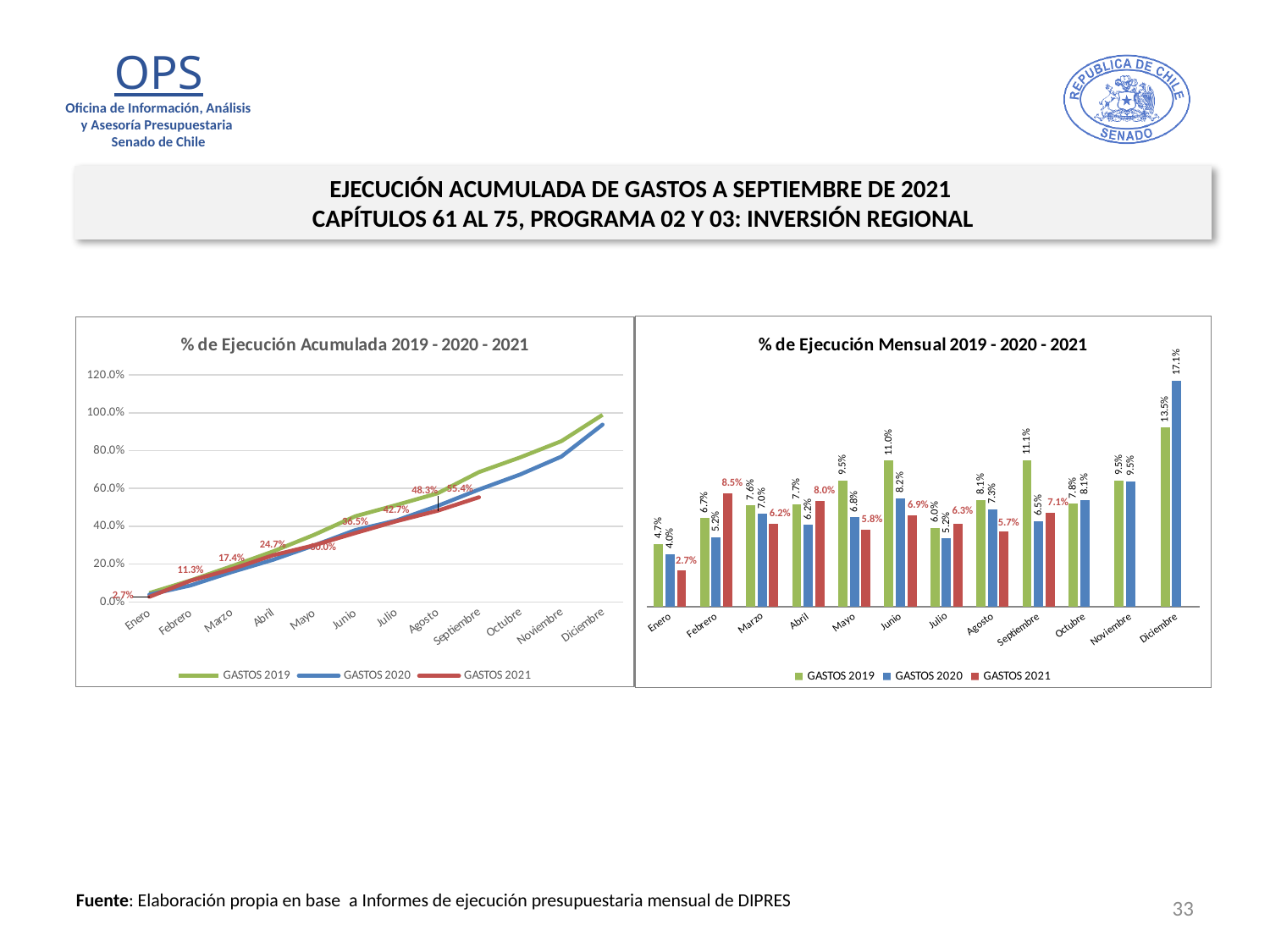
In the chart titled '% de Ejecución Mensual 2019 - 2020 - 2021', what is the difference between GASTOS 2019 and GASTOS 2020 in Junio? 2.8% In the chart titled '% de Ejecución Acumulada 2019 - 2020 - 2021', what is the labelled value for GASTOS 2021 in Septiembre? 55.4% How many series does the legend list in the chart titled '% de Ejecución Acumulada 2019 - 2020 - 2021'? 3 In the chart titled '% de Ejecución Mensual 2019 - 2020 - 2021', which month has the lowest value for GASTOS 2021? Enero In the chart titled '% de Ejecución Acumulada 2019 - 2020 - 2021', do the GASTOS 2021 values rise or fall from Enero to Septiembre? Rise In the chart titled '% de Ejecución Acumulada 2019 - 2020 - 2021', is the value for GASTOS 2019 in Diciembre greater or less than 80.0%? greater What kind of chart is the one titled '% de Ejecución Mensual 2019 - 2020 - 2021'? Bar chart In the chart titled '% de Ejecución Mensual 2019 - 2020 - 2021', which is larger in Abril: GASTOS 2019 or GASTOS 2021? GASTOS 2021 In the chart titled '% de Ejecución Mensual 2019 - 2020 - 2021', which month has the highest value for GASTOS 2019? Diciembre How many months are shown on the x axis of the chart titled '% de Ejecución Mensual 2019 - 2020 - 2021'? 12 In the chart titled '% de Ejecución Mensual 2019 - 2020 - 2021', what is the value for GASTOS 2020 in Diciembre? 17.1% In the chart titled '% de Ejecución Mensual 2019 - 2020 - 2021', what is the value for GASTOS 2021 in Febrero? 8.5%